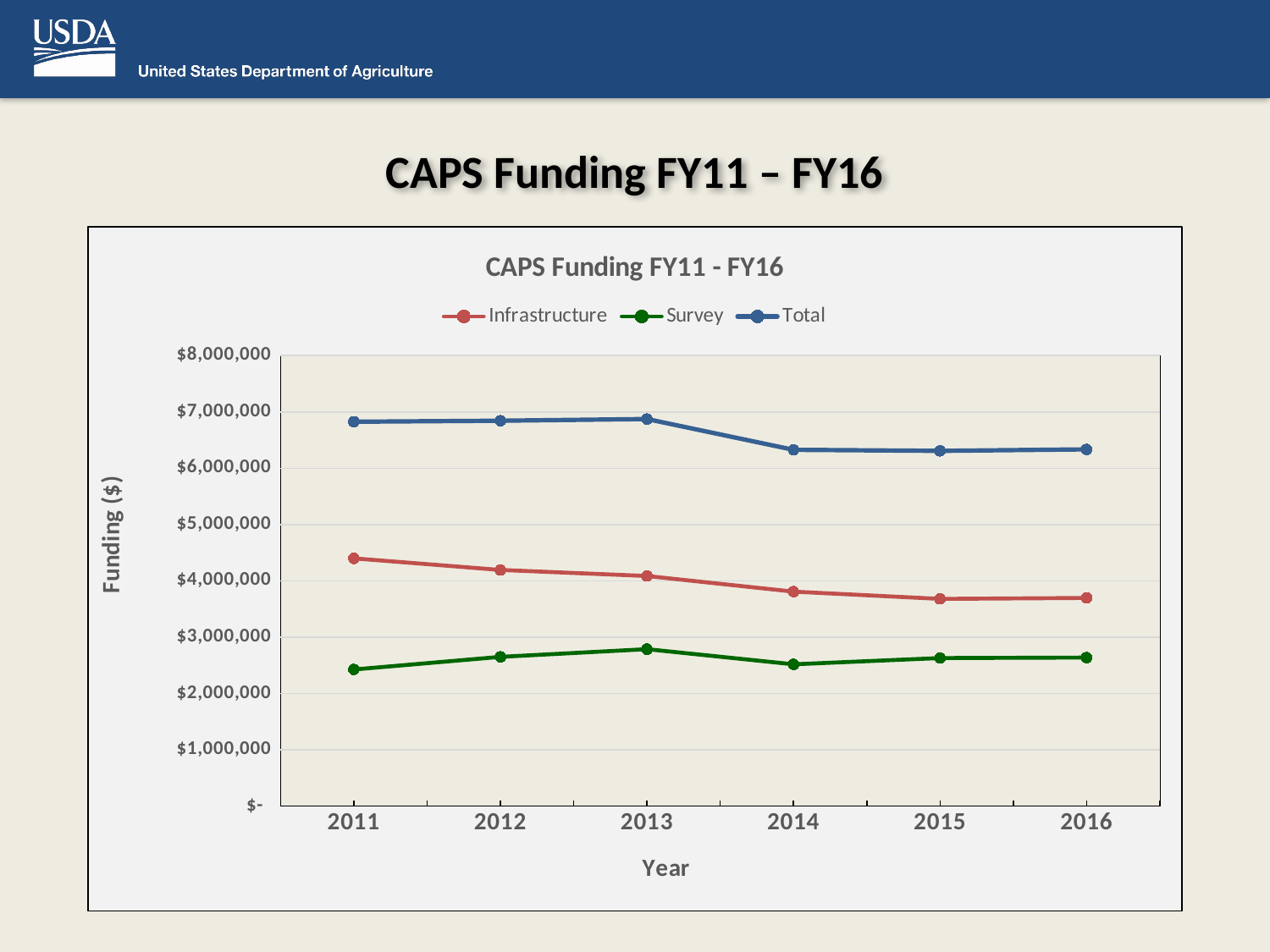
How many years are plotted along the x axis? 6 How many series does the legend list? 3 Is the Survey value for 2013 greater or less than $3,000,000? less Is the Infrastructure value for 2015 greater or less than $4,000,000? less Is the Infrastructure value for 2011 greater or less than $4,000,000? greater What is the label of the y axis? Funding ($) In which year is the Survey value highest? 2013 In which year is the Infrastructure value highest? 2011 Which series are listed in the legend? Infrastructure, Survey, Total Does the Infrastructure series rise or fall from 2011 to 2016? fall What kind of chart is shown on the slide? line chart